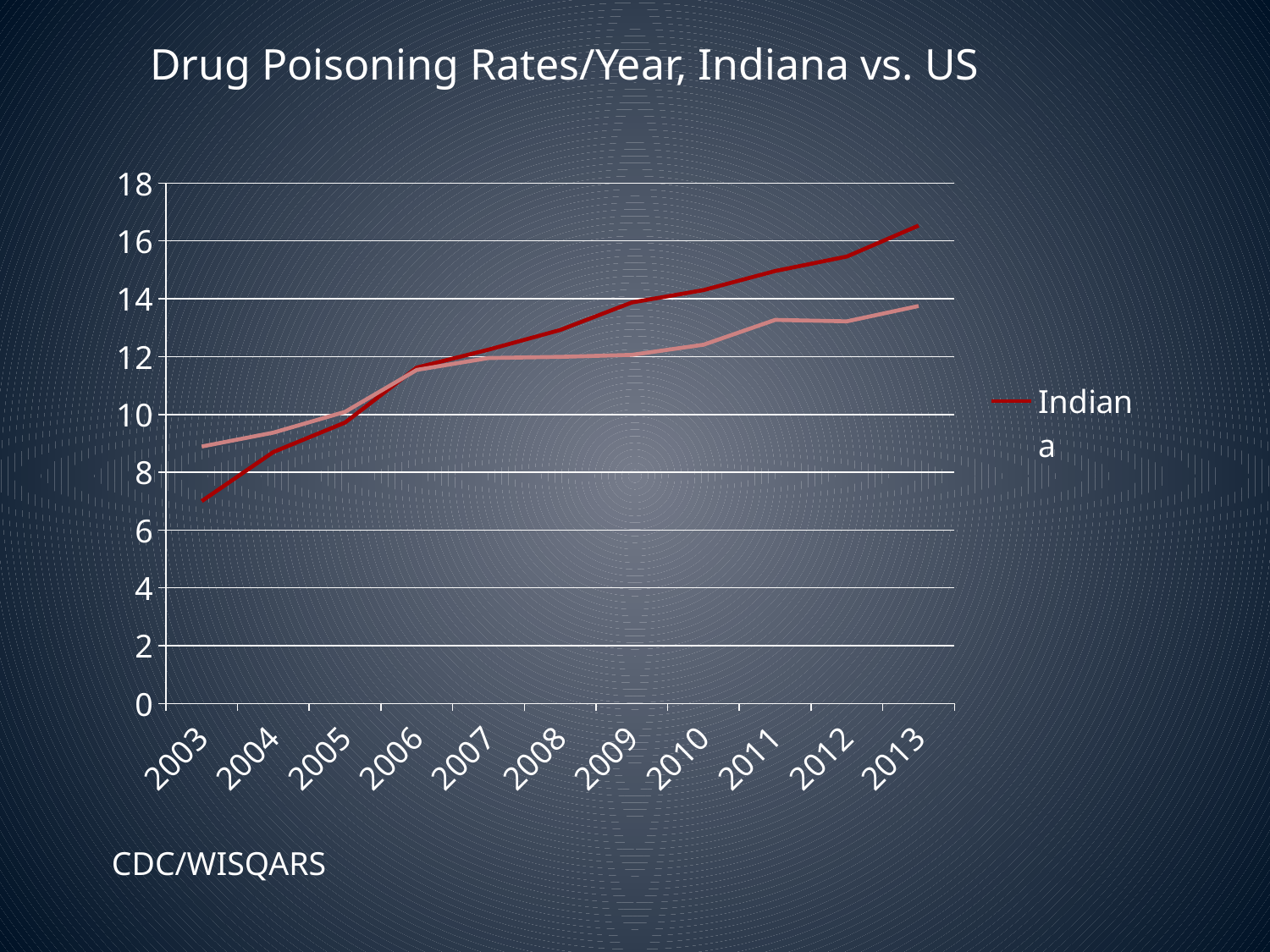
Is the value for Indiana in 2006 greater or less than 12? less Does the Indiana line generally rise or fall from 2003 to 2013? rise In 2013, which line is higher: the Indiana line or the lighter pink line? Indiana What is the title of the chart? Drug Poisoning Rates/Year, Indiana vs. US How many years are plotted along the x axis? 11 Is the value for Indiana in 2003 greater or less than 8? less What kind of chart is shown on the slide? line chart Is the value of the lighter pink line in 2013 greater or less than 14? less Which year has the lowest value for the Indiana line? 2003 Which year has the highest value for the Indiana line? 2013